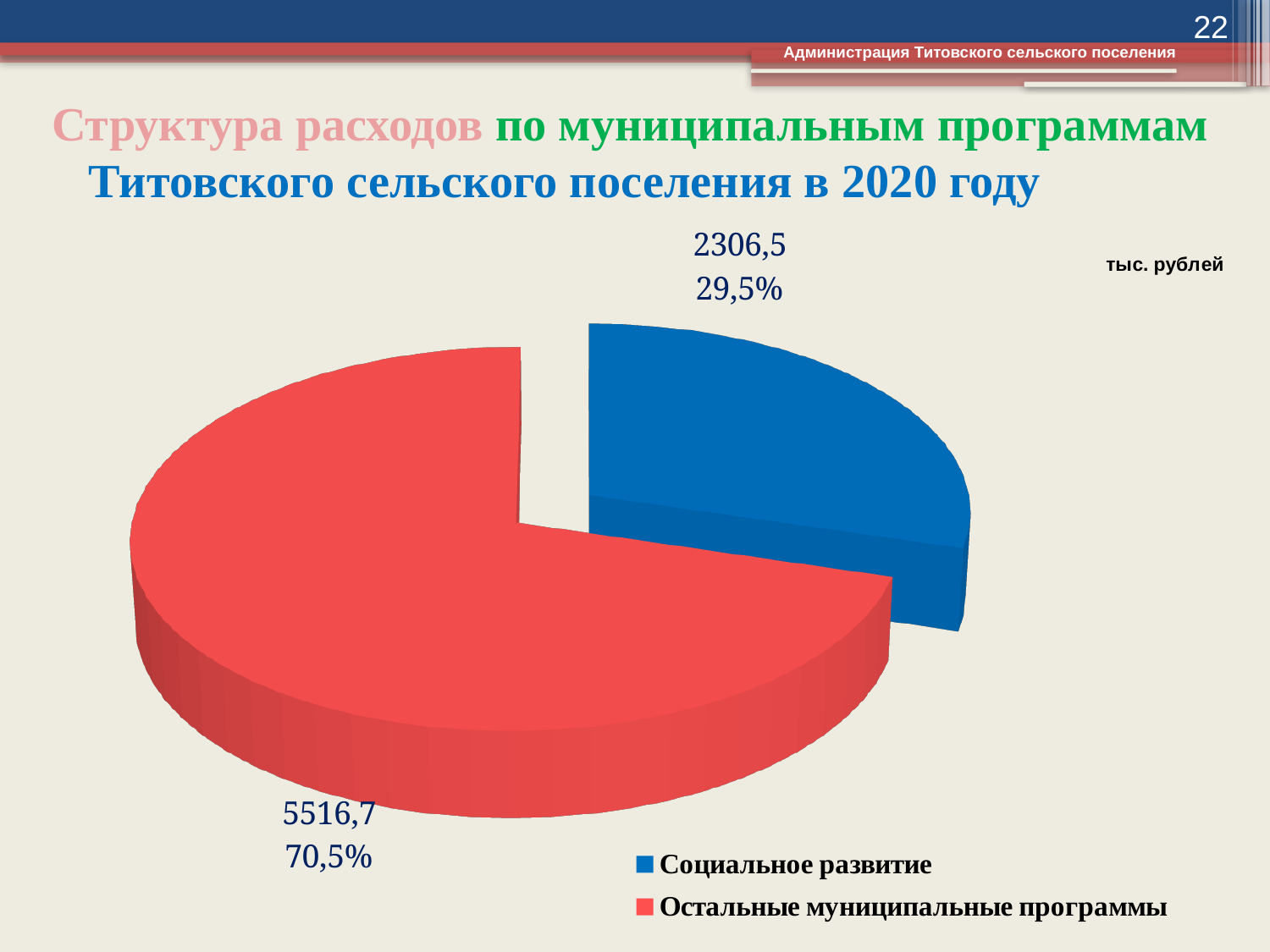
Which category has the smallest slice of the pie? Социальное развитие Which category has the largest slice of the pie? Остальные муниципальные программы In what units are the values on the chart given? тыс. рублей What is the difference between the values for Остальные муниципальные программы and Социальное развитие? 3210,2 Which is larger: Социальное развитие or Остальные муниципальные программы? Остальные муниципальные программы What share of the pie does Остальные муниципальные программы take? 70,5% What is the value for Остальные муниципальные программы? 5516,7 How many slices does the pie chart have? 2 What kind of chart is shown on the slide? pie chart What colour is the slice for Социальное развитие? blue What share of the pie does Социальное развитие take? 29,5% What is the value for Социальное развитие? 2306,5